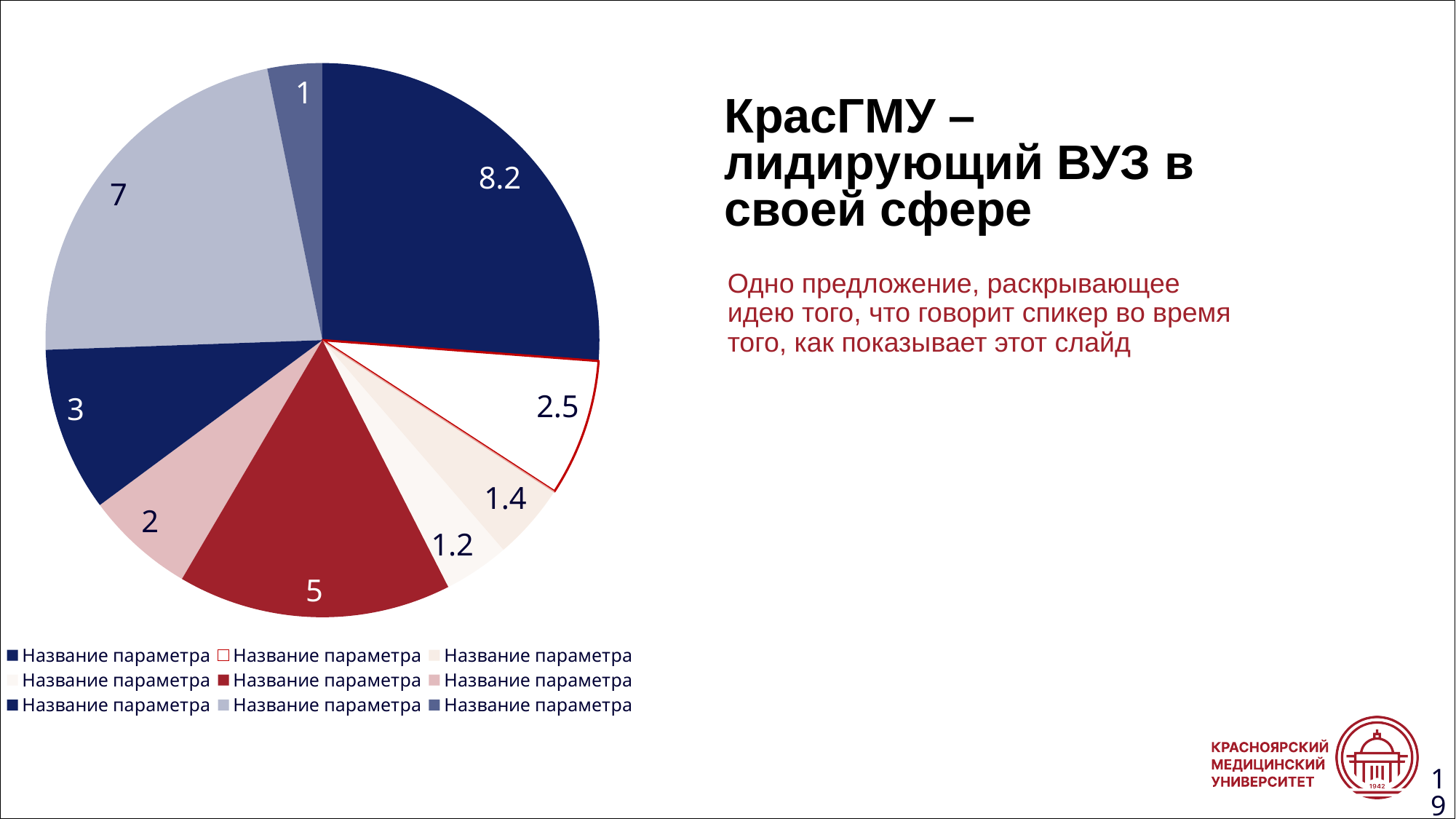
How many slices does the pie chart have? 9 Which is larger: the slice labeled 2.5 or the slice labeled 1.4? 2.5 What is the value of the smallest slice in the pie chart? 1 How many entries does the legend of the pie chart list? 9 Which is larger: the dark red slice or the light grey-blue slice labeled 7? The light grey-blue slice (7) What is the total of all the slice values in the pie chart? 31.3 What value is labeled on the white slice with the red outline? 2.5 What text is used for every entry in the pie chart's legend? Название параметра What kind of chart is shown on the slide? Pie chart What is the difference between the slice labeled 8.2 and the slice labeled 7? 1.2 What value is labeled on the dark red slice of the pie chart? 5 What is the value of the largest slice in the pie chart? 8.2